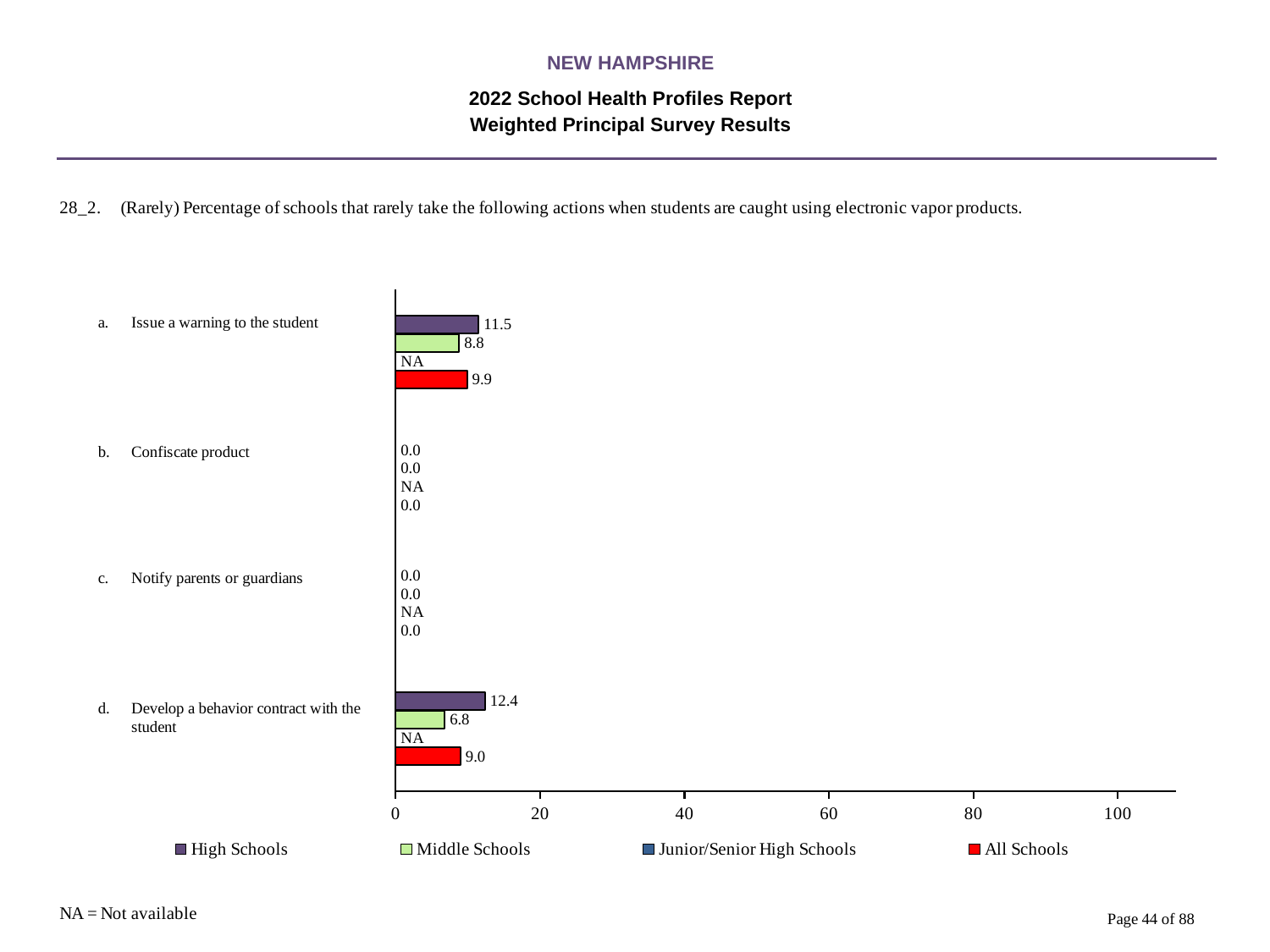
What is the High Schools value for 'Issue a warning to the student'? 11.5 What is the difference between the High Schools and Middle Schools values for 'Develop a behavior contract with the student'? 5.6 What is the Junior/Senior High Schools value for 'Confiscate product'? NA Is the High Schools value for 'Develop a behavior contract with the student' greater or less than 20? less How many series does the legend list? 4 Which is larger, the Middle Schools value for 'Issue a warning to the student' or for 'Develop a behavior contract with the student'? Issue a warning to the student Which category has the highest High Schools value? Develop a behavior contract with the student What kind of chart is shown on the slide? bar chart What is the Middle Schools value for 'Develop a behavior contract with the student'? 6.8 How many action categories are shown on the chart? 4 What is the difference between the High Schools and All Schools values for 'Issue a warning to the student'? 1.6 What is the All Schools value for 'Issue a warning to the student'? 9.9